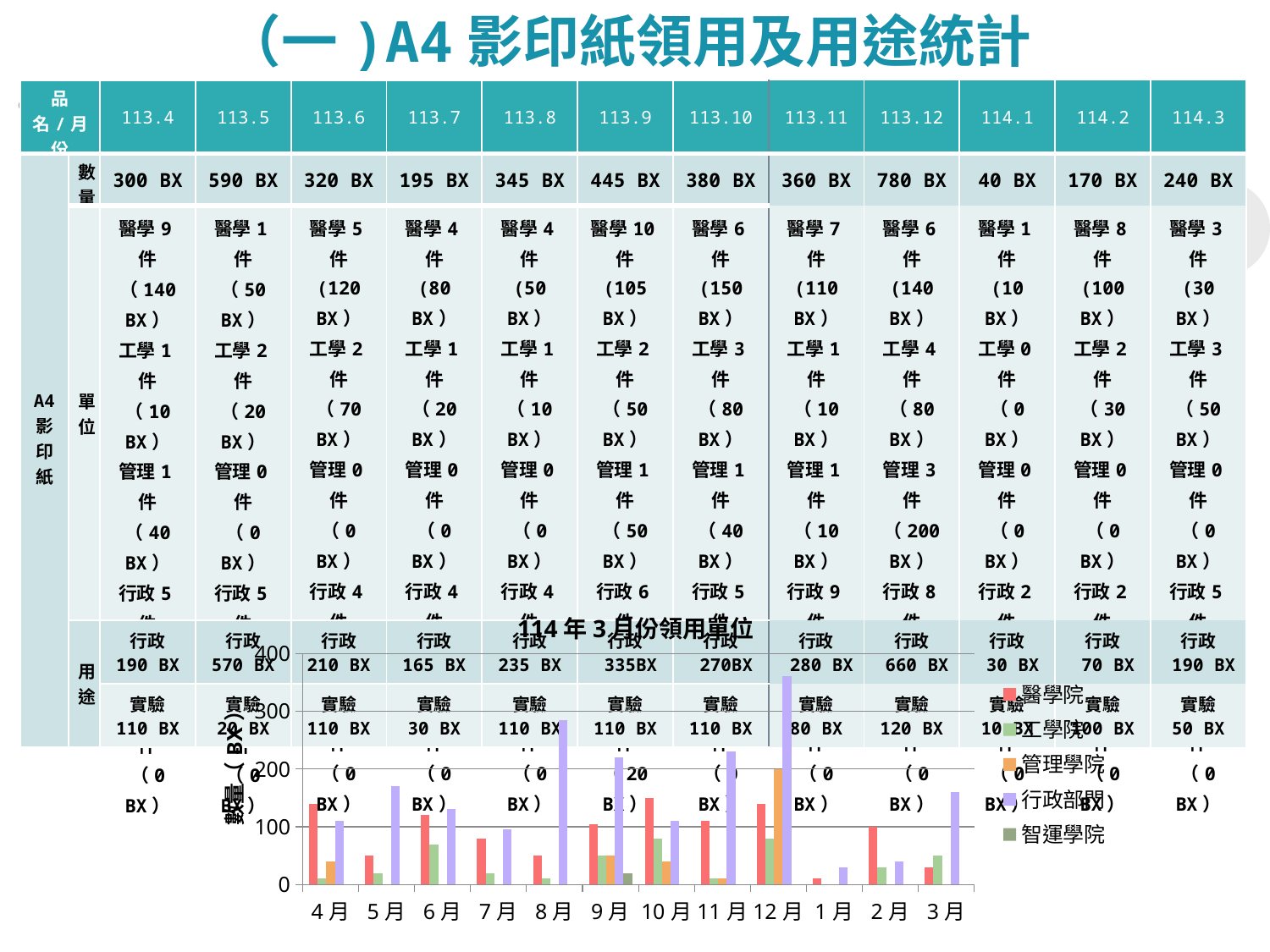
Is the value for 醫學院 in 1月 greater or less than 100? less What is the label on the chart's y axis? 數量（BX） What is the title of the chart? 114年3月份領用單位 Is the value for 行政部門 in 12月 greater or less than 300? greater How many months are shown along the x axis of the chart? 12 Is the value for 醫學院 in 4月 greater or less than 100? greater Which is larger, the 醫學院 value in 4月 or in 5月? 4月 In which month is the 行政部門 bar the tallest? 12月 Which is larger, the 管理學院 value in 12月 or in 9月? 12月 How many series does the chart legend list? 5 What kind of chart is shown on the slide? bar chart